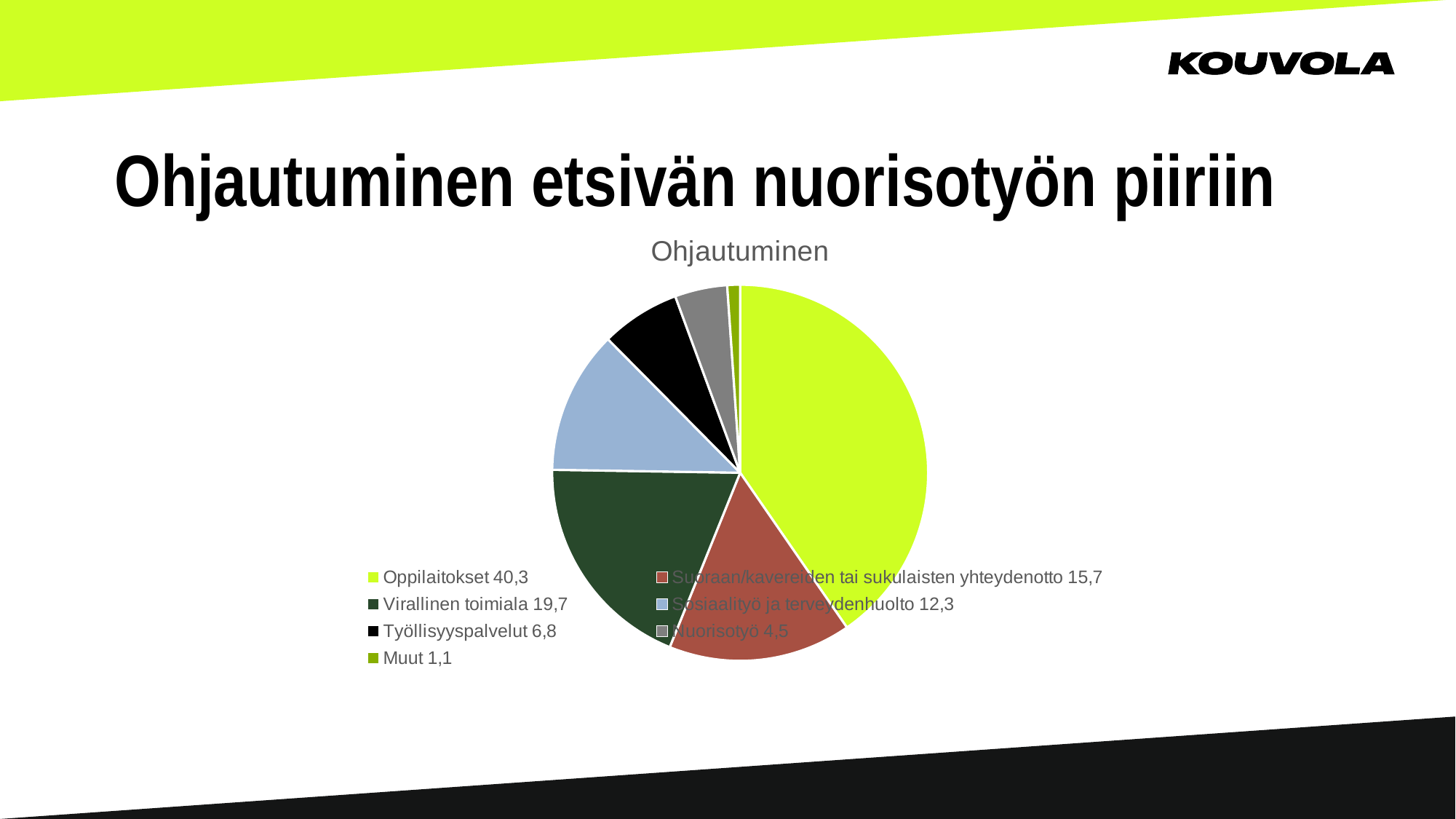
What is the value for Nuorisotyö? 4,5 What is the value for Sosiaalityö ja terveydenhuolto? 12,3 What is the value for Oppilaitokset? 40,3 Which is larger, Suoraan/kavereiden tai sukulaisten yhteydenotto or Sosiaalityö ja terveydenhuolto? Suoraan/kavereiden tai sukulaisten yhteydenotto What type of chart is shown on the slide? Pie chart How many slices does the pie chart have? 7 Which category has the smallest slice of the pie? Muut What is the difference between the values for Oppilaitokset and Virallinen toimiala? 20,6 Which category has the largest slice of the pie? Oppilaitokset What is the title of the chart? Ohjautuminen What is the value for Virallinen toimiala? 19,7 What colour is the slice for Työllisyyspalvelut? Black